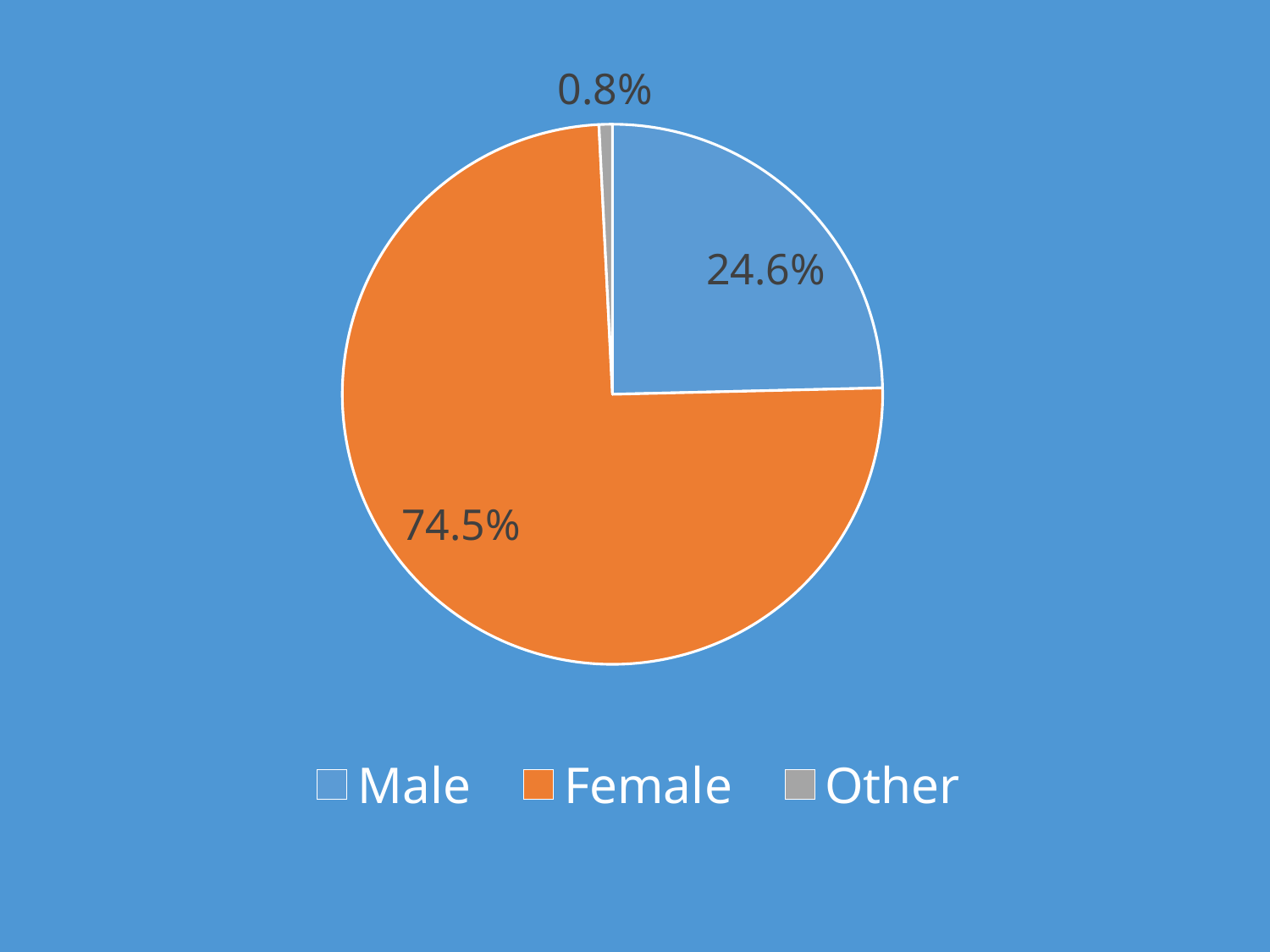
What is the difference in percentage points between the Female and Male shares? 49.9 Which is larger, the Male share or the Other share? Male Which category has the smallest share of the pie? Other Which category has the largest share of the pie? Female What colour is the Female slice? orange What kind of chart is shown on the slide? pie chart How many entries does the legend list? 3 What percentage of the pie is Other? 0.8% What percentage of the pie is Female? 74.5% How many categories does the pie chart have? 3 What percentage of the pie is Male? 24.6% What is the difference in percentage points between the Male and Other shares? 23.8